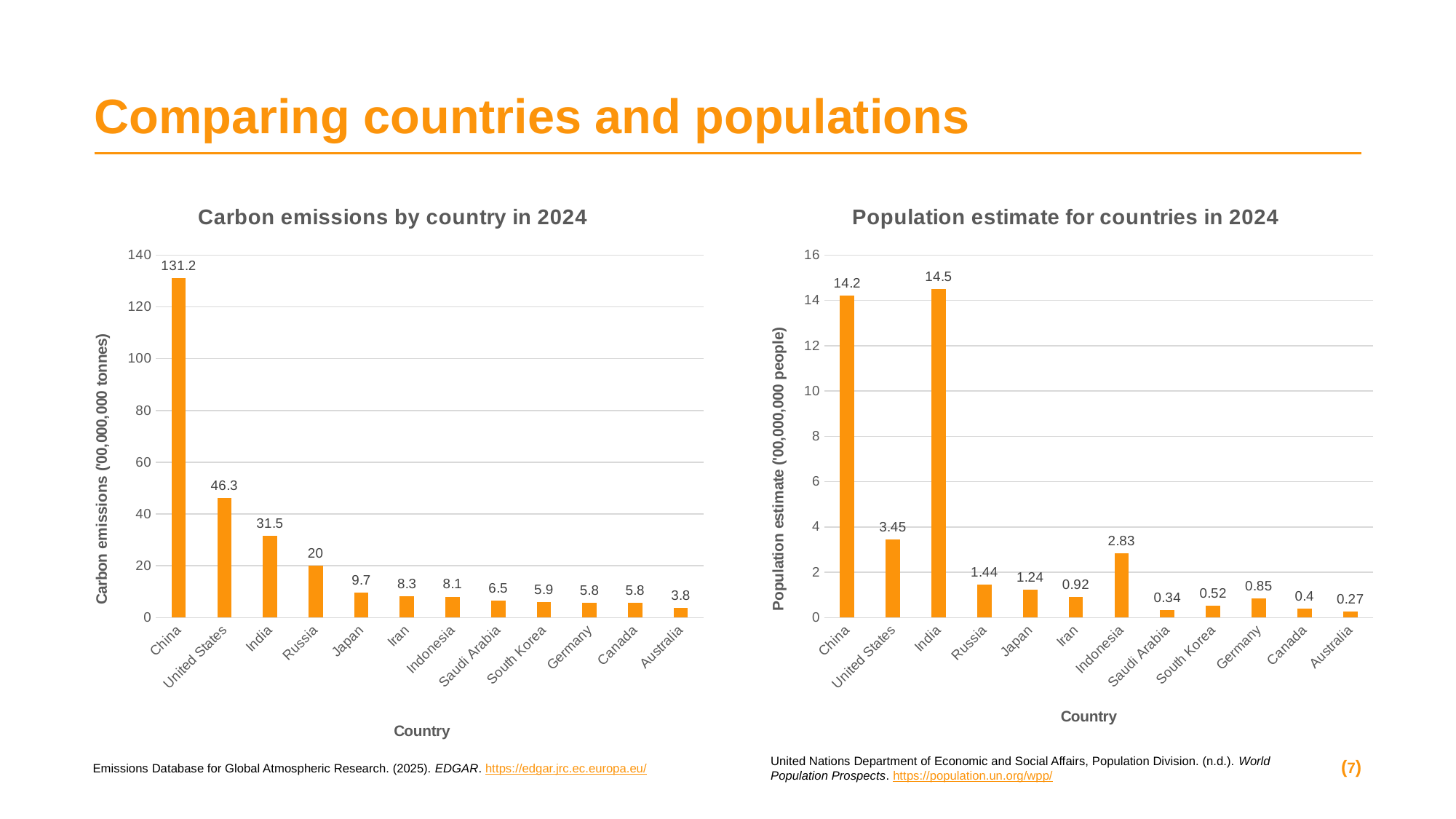
What kind of chart is the 'Population estimate for countries in 2024' chart? Bar chart In the 'Population estimate for countries in 2024' chart, what is the value for Saudi Arabia? 0.34 In the 'Population estimate for countries in 2024' chart, what is the value for Indonesia? 2.83 In the 'Carbon emissions by country in 2024' chart, which country has the lowest value? Australia In the 'Carbon emissions by country in 2024' chart, do the values generally rise or fall from left to right? Fall In the 'Population estimate for countries in 2024' chart, which is larger, the value for Japan or the value for Russia? Russia In the 'Carbon emissions by country in 2024' chart, what is the difference between the values for United States and India? 14.8 In the 'Carbon emissions by country in 2024' chart, what is the value for China? 131.2 In the 'Carbon emissions by country in 2024' chart, what is the difference between the values for Russia and Japan? 10.3 In the 'Population estimate for countries in 2024' chart, which country has the highest value? India What is the y-axis label of the 'Population estimate for countries in 2024' chart? Population estimate ('00,000,000 people) In the 'Carbon emissions by country in 2024' chart, how many countries are shown? 12